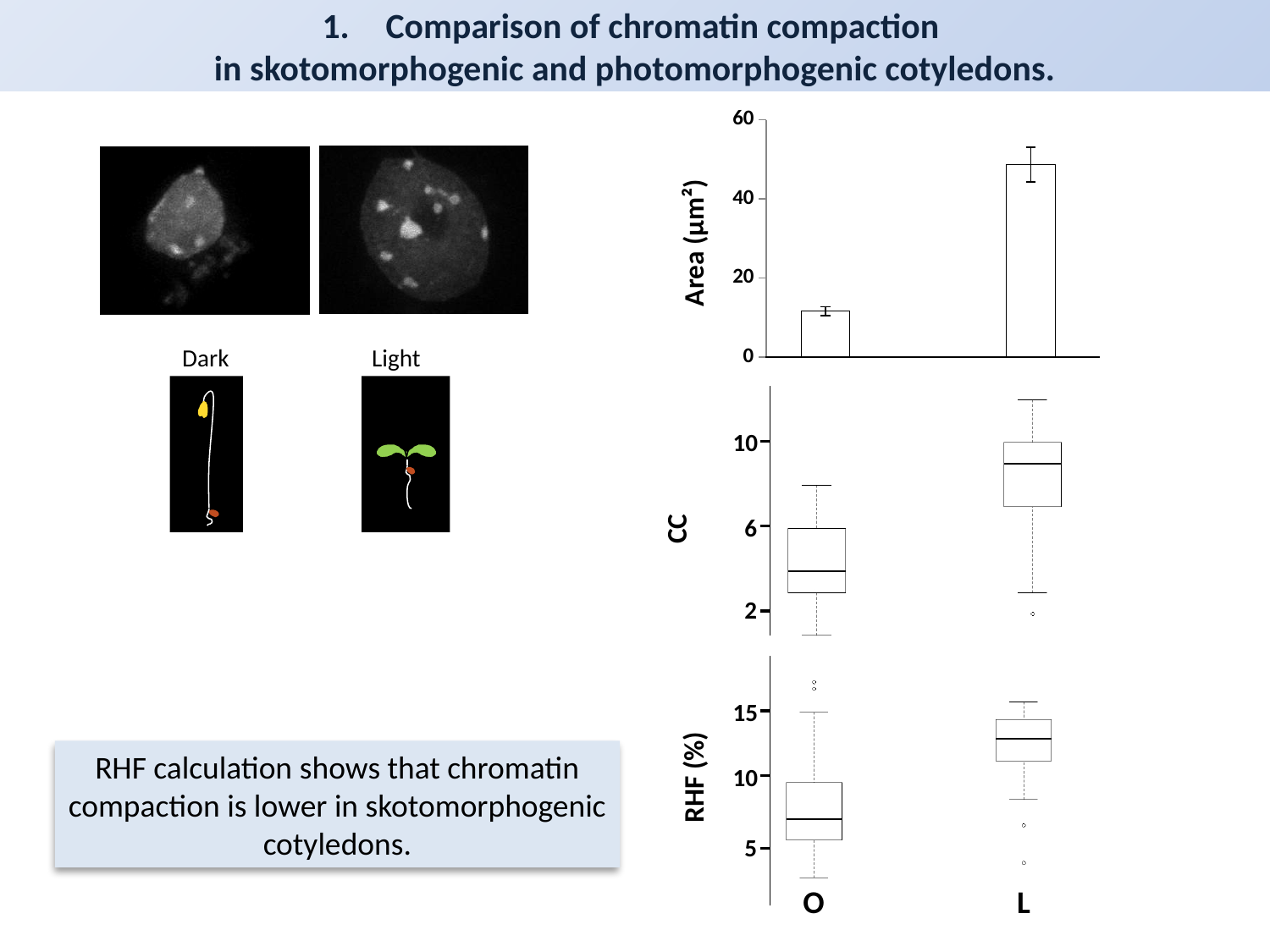
In the top chart (Area (µm²)), which category has the shorter bar? O What is the y-axis label of the top chart on the right? Area (µm²) In the top chart (Area (µm²)), is the value for O greater or less than 20? less How many categories are shown along the x axis of the charts on the right? 2 In the bottom chart (RHF (%)), is the median for L greater or less than 10? greater What kind of chart is the top chart with the Area (µm²) axis? bar chart In the top chart (Area (µm²)), is the value for L greater or less than 40? greater In the middle chart (CC), which category has the higher median, O or L? L In the top chart (Area (µm²)), which category has the taller bar, O or L? L